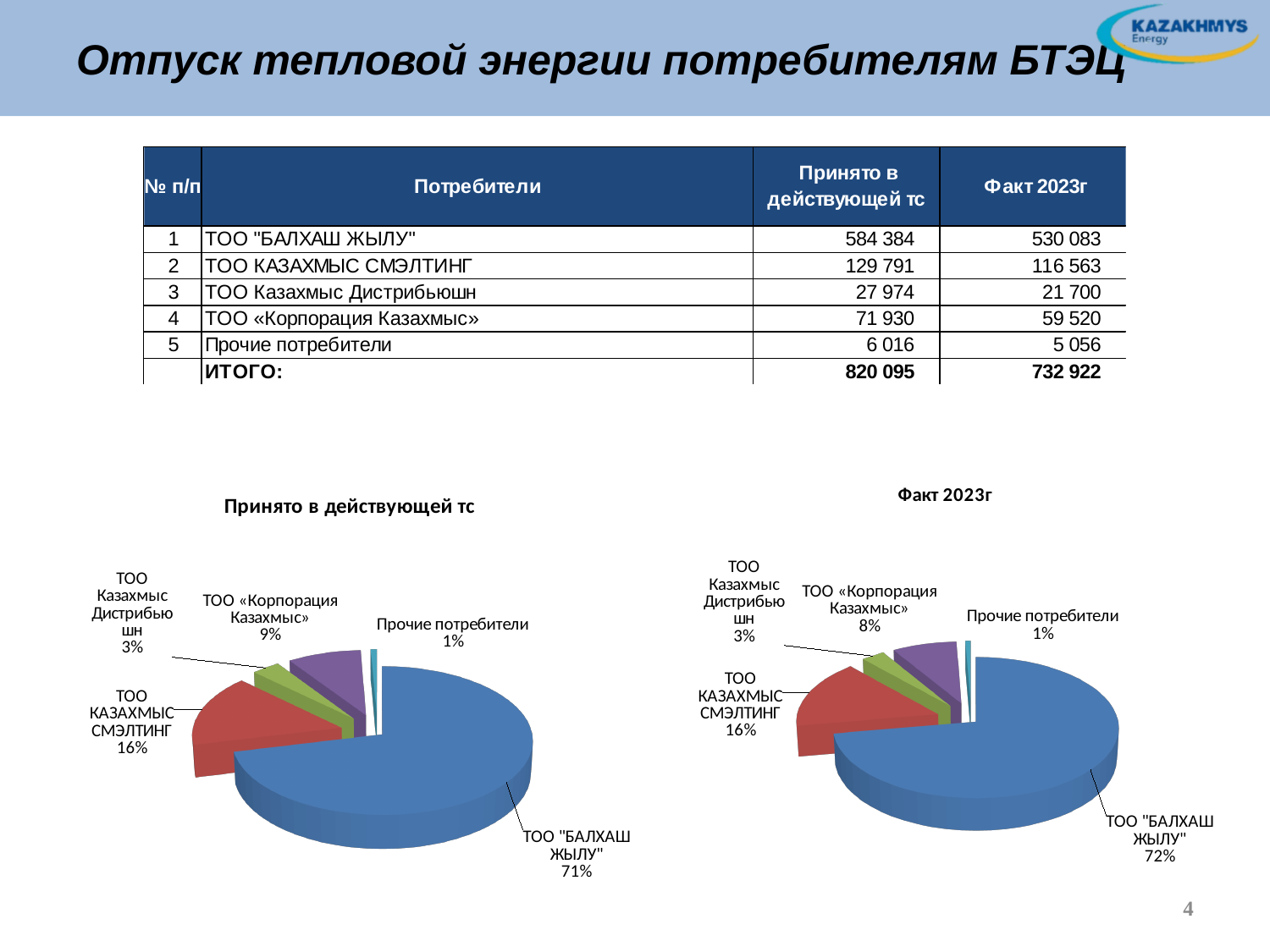
In the pie chart titled "Принято в действующей тс", which category has the largest slice? ТОО "БАЛХАШ ЖЫЛУ" In the pie chart titled "Факт 2023г", which category has the smallest slice? Прочие потребители In the pie chart titled "Принято в действующей тс", which is larger: the share of ТОО КАЗАХМЫС СМЭЛТИНГ or the share of ТОО «Корпорация Казахмыс»? ТОО КАЗАХМЫС СМЭЛТИНГ In the pie chart titled "Факт 2023г", what share does ТОО «Корпорация Казахмыс» have? 8% How many slices does the pie chart titled "Принято в действующей тс" have? 5 What kind of chart is the chart titled "Факт 2023г"? Pie chart In the pie chart titled "Принято в действующей тс", what is the difference in percentage points between the share of ТОО КАЗАХМЫС СМЭЛТИНГ and the share of ТОО Казахмыс Дистрибьюшн? 13% In the pie chart titled "Факт 2023г", what share does ТОО КАЗАХМЫС СМЭЛТИНГ have? 16% In the pie chart titled "Принято в действующей тс", what share does ТОО «Корпорация Казахмыс» have? 9% What is the title of the pie chart on the left side of the slide? Принято в действующей тс